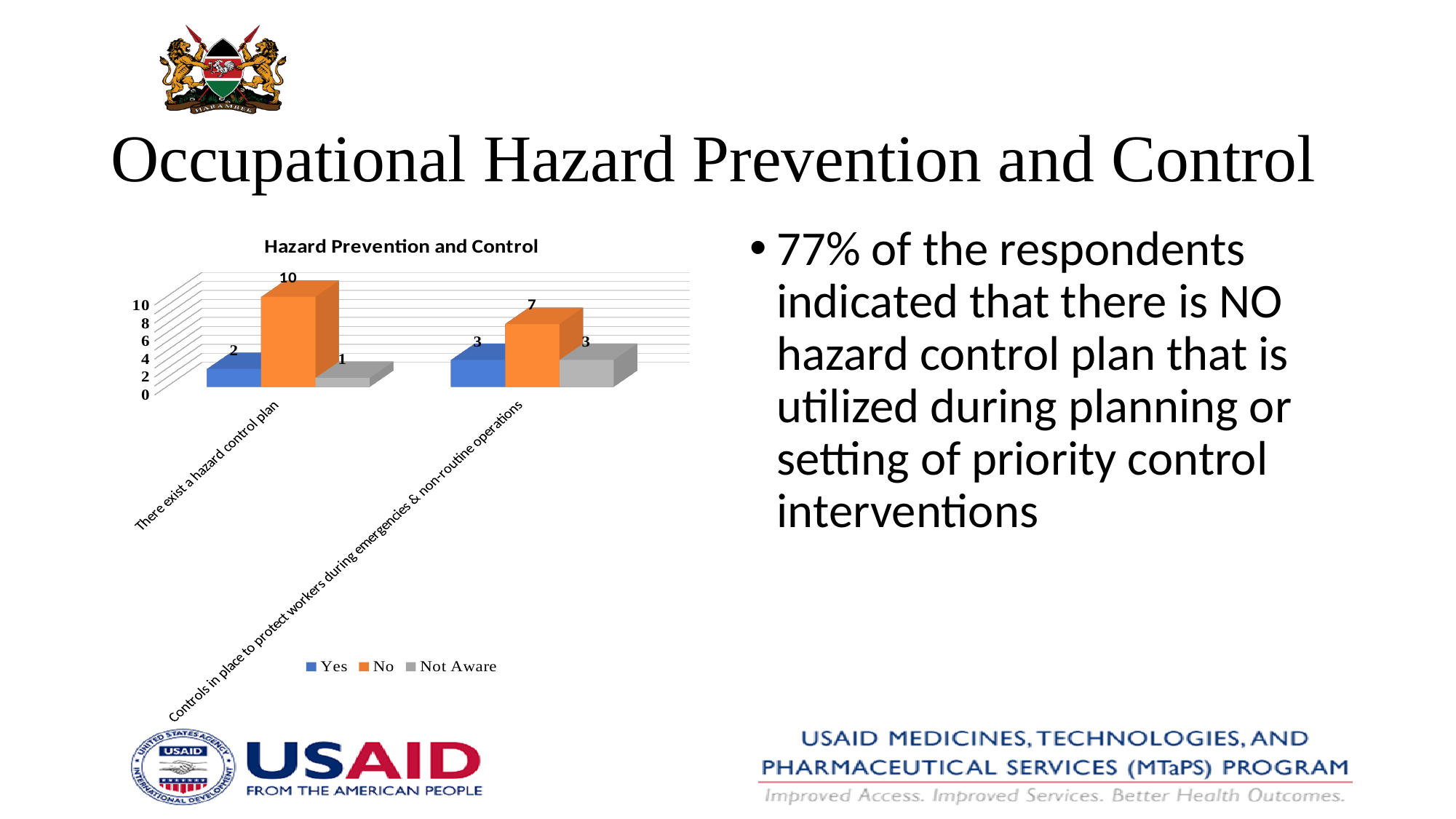
What is the value for "No" for "There exist a hazard control plan"? 10 Which series has the highest value for "There exist a hazard control plan"? No What is the title of the chart? Hazard Prevention and Control What type of chart is shown on the slide? bar chart What is the value for "Yes" for "There exist a hazard control plan"? 2 What is the value for "Not Aware" for "Controls in place to protect workers during emergencies & non-routine operations"? 3 Which series has the lowest value for "There exist a hazard control plan"? Not Aware What is the value for "No" for "Controls in place to protect workers during emergencies & non-routine operations"? 7 Which is larger: the "No" value for "There exist a hazard control plan" or the "No" value for "Controls in place to protect workers during emergencies & non-routine operations"? There exist a hazard control plan What is the difference between the "No" and "Yes" values for "There exist a hazard control plan"? 8 How many series does the legend list? 3 How many categories are shown on the x axis? 2